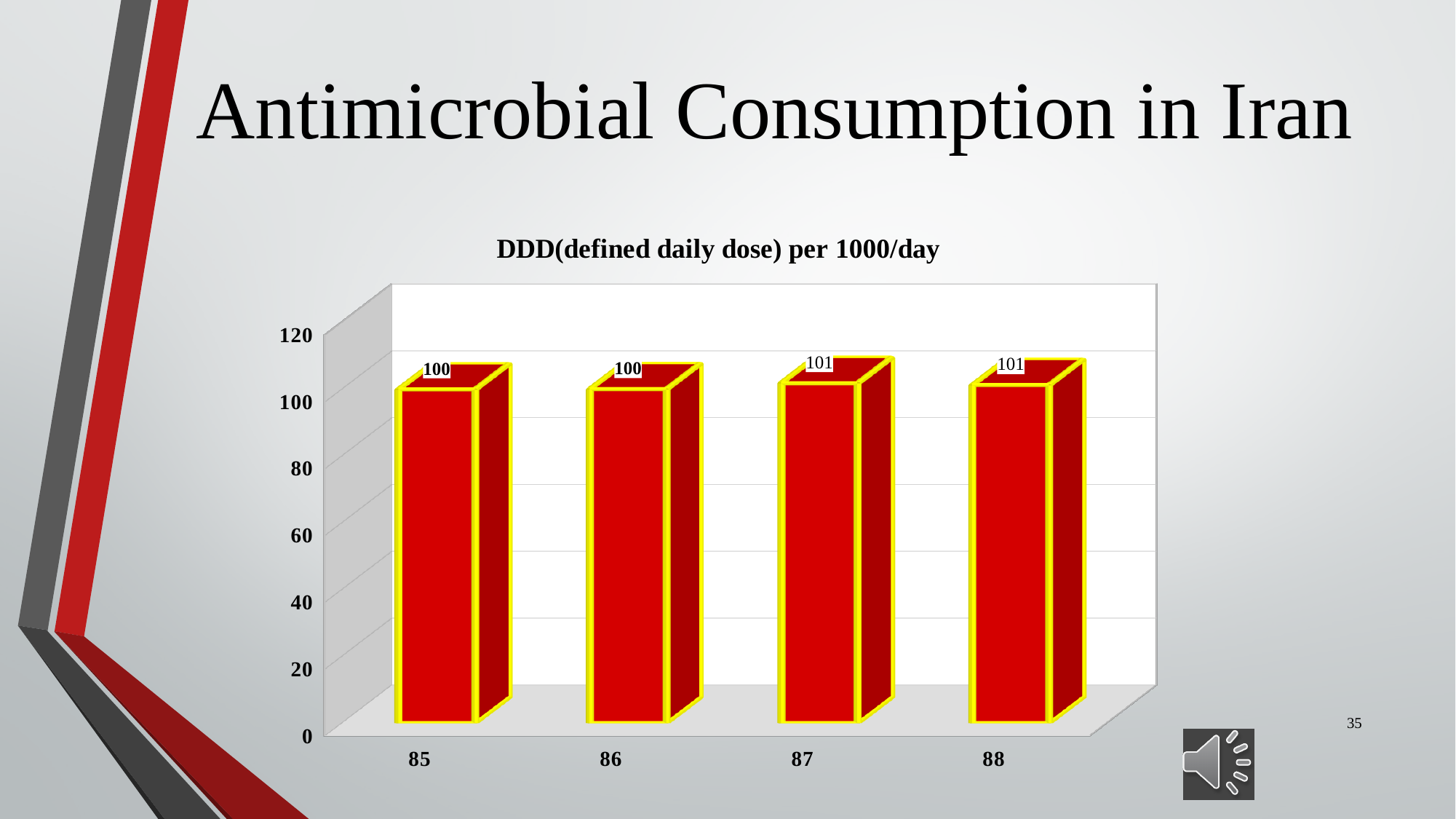
Is the value for 88 greater or less than 120? less Do the values rise or fall from 85 to 88? rise What is the value for 88? 101 What is the value for 85? 100 What colour are the bars in the chart? red What is the value for 87? 101 What is the value for 86? 100 Is the value for 86 greater or less than 80? greater What is the title of the chart? DDD(defined daily dose) per 1000/day What kind of chart is shown on the slide? bar chart How many categories are shown on the x axis? 4 What is the difference between the values for 87 and 85? 1